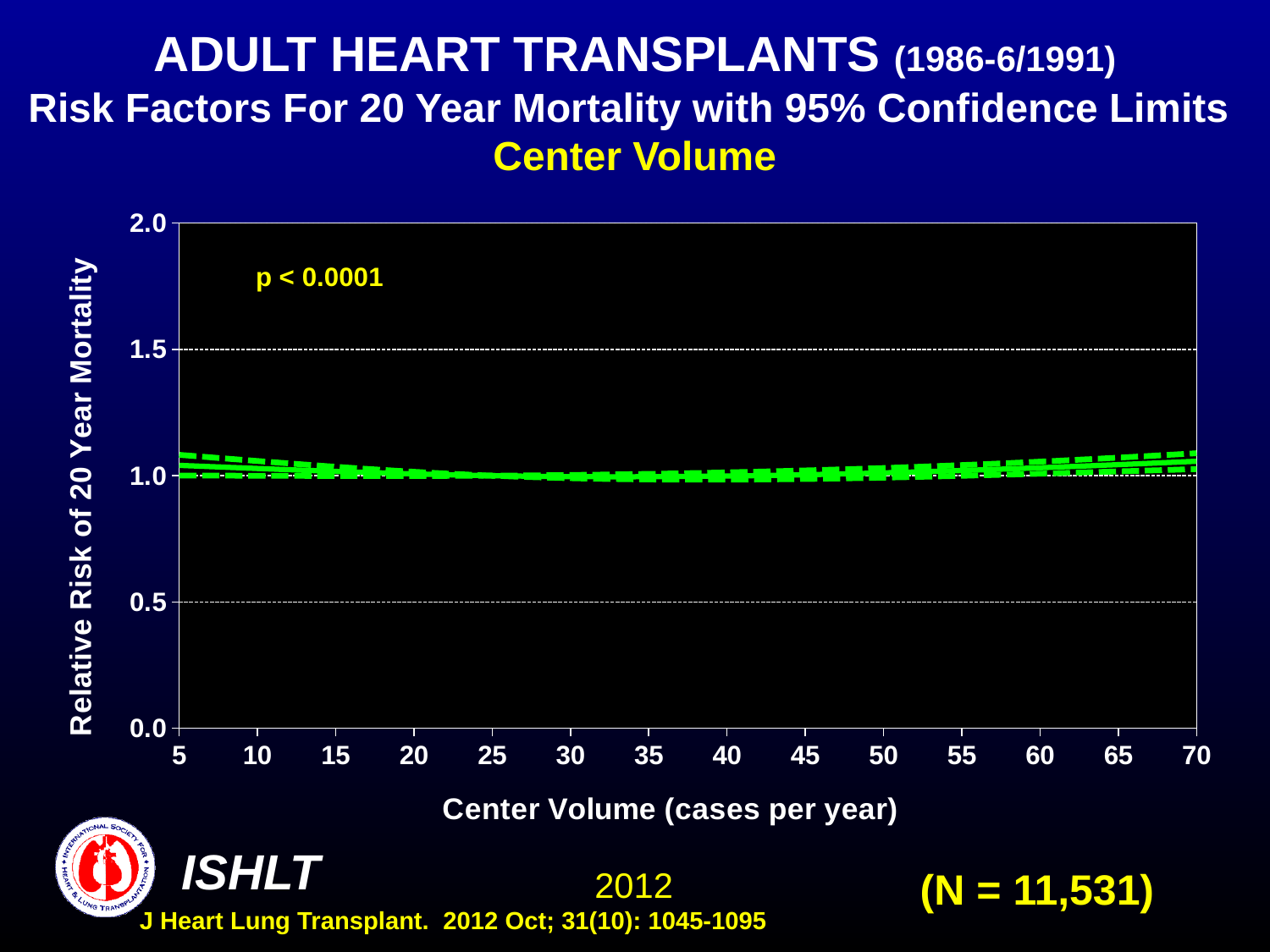
What is the label of the x axis? Center Volume (cases per year) What is the highest center volume shown on the x axis? 70 Is the relative risk at a center volume of 60 cases per year greater or less than 1.5? less How many tick marks are labelled on the x axis? 14 What is the lowest center volume shown on the x axis? 5 What kind of chart is shown on the slide? line chart Is the relative risk at a center volume of 40 cases per year greater or less than 1.5? less Is the relative risk at a center volume of 10 cases per year greater or less than 0.5? greater